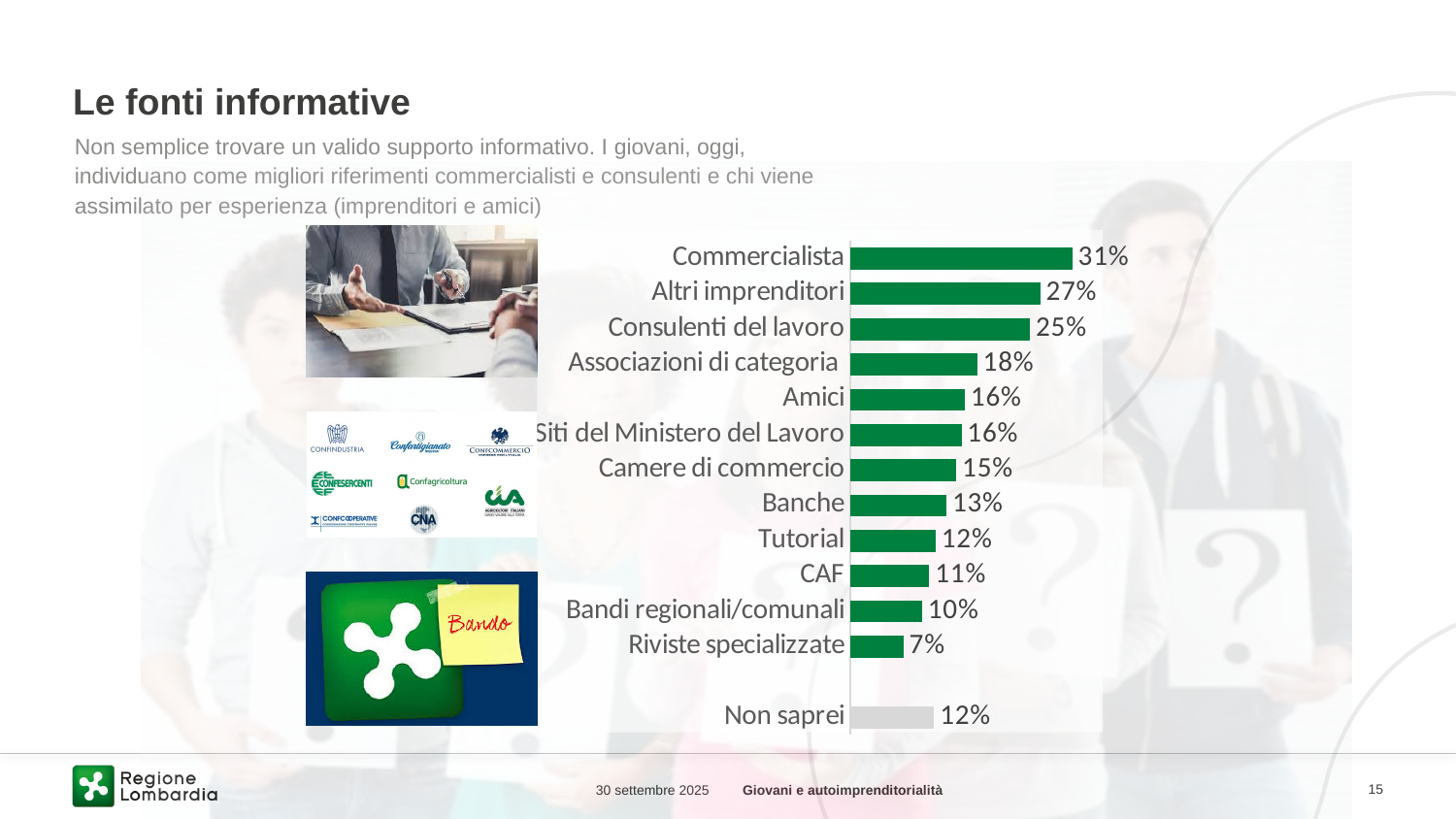
What is the difference between the values for Commercialista and Altri imprenditori? 4% What percentage is shown for Banche? 13% What value is shown for Consulenti del lavoro? 25% Which is larger, the value for Camere di commercio or the value for CAF? Camere di commercio How many categories are shown in the chart? 13 What kind of chart is shown on the slide? Bar chart Which category has the highest value in the chart? Commercialista What is the difference between the values for Associazioni di categoria and Riviste specializzate? 11% Which category has the lowest value in the chart? Riviste specializzate Which bar in the chart is coloured grey instead of green? Non saprei What value is shown for Non saprei? 12% What percentage is shown for Commercialista? 31%